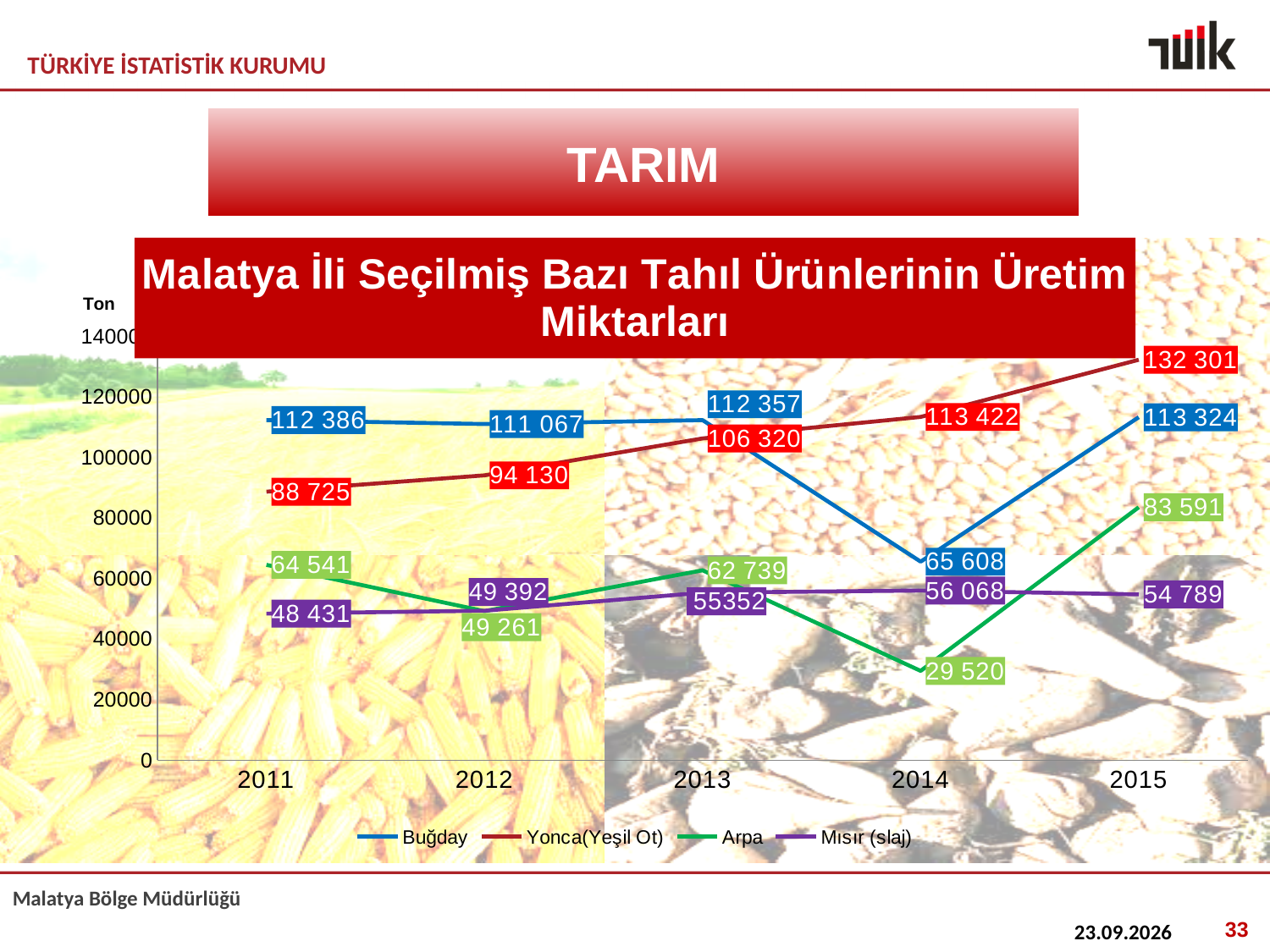
What kind of chart is shown on the slide? line chart Does Yonca(Yeşil Ot) production rise or fall from 2011 to 2015? rises How many series does the legend list? 4 How many years are shown on the x axis? 5 What is the Yonca(Yeşil Ot) production value for 2015? 132 301 What is the Mısır (slaj) production value for 2013? 55352 What is the difference between Yonca(Yeşil Ot) production in 2015 and 2014? 18 879 In which year is Arpa production lowest? 2014 In which year is Yonca(Yeşil Ot) production highest? 2015 What is the Buğday production value for 2014? 65 608 What colour is the Arpa line in the legend? green In 2013, which is larger: Buğday or Yonca(Yeşil Ot) production? Buğday